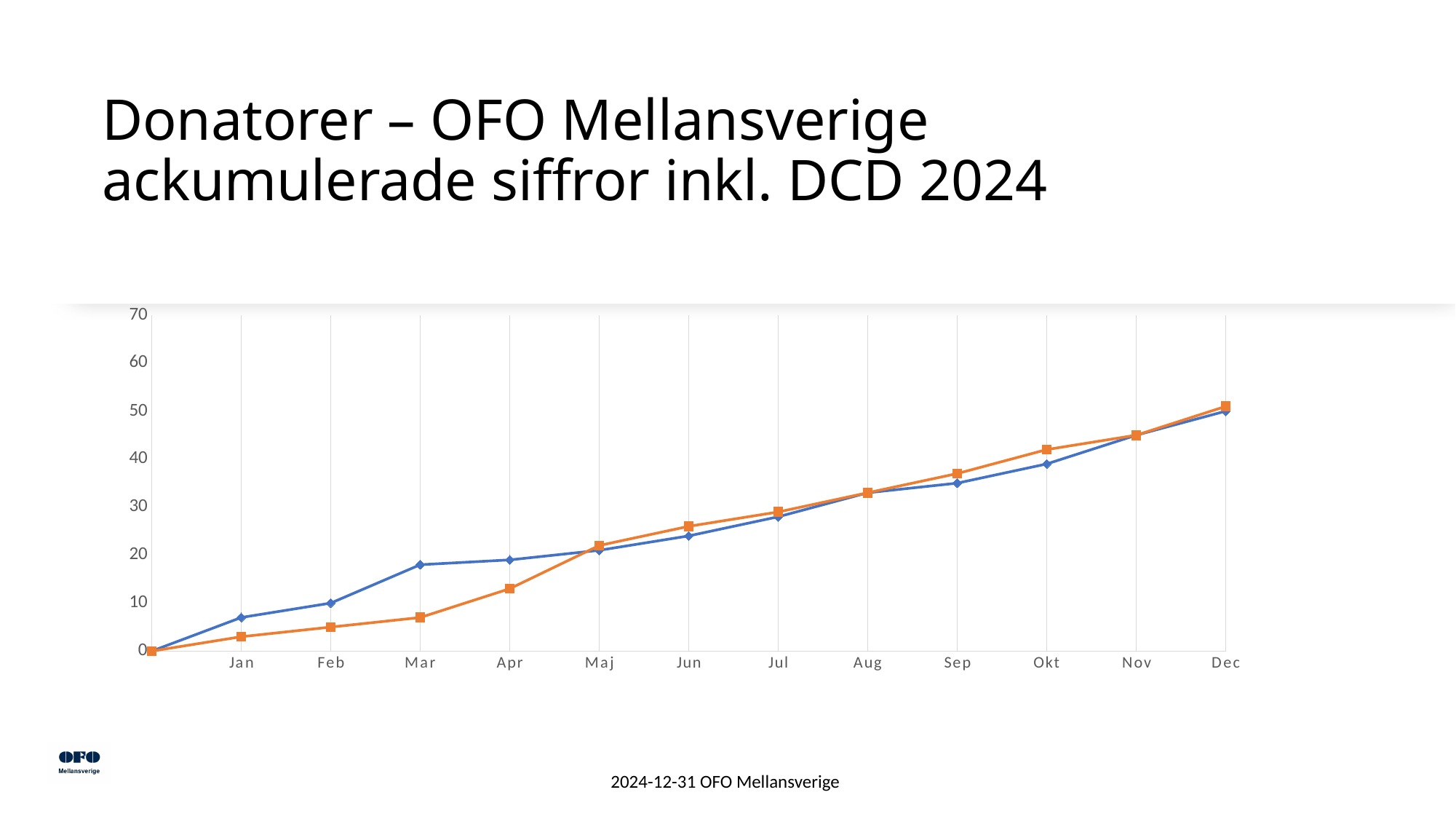
Do the values of the blue line rise or fall from Jan to Dec? rise Is the value of the blue line in Jan greater or less than 10? less In which month does the orange line reach its highest value? Dec What kind of chart is shown on the slide? line chart Is the value of the orange line in Nov greater or less than 50? less In Okt, which line has the higher value, the blue line or the orange line? orange line What is the highest value shown on the y axis? 70 Is the value of the blue line in Mar greater or less than 20? less How many month labels are shown on the x axis? 12 In Mar, which line has the higher value, the blue line or the orange line? blue line Do the values of the orange line rise or fall from Jan to Dec? rise